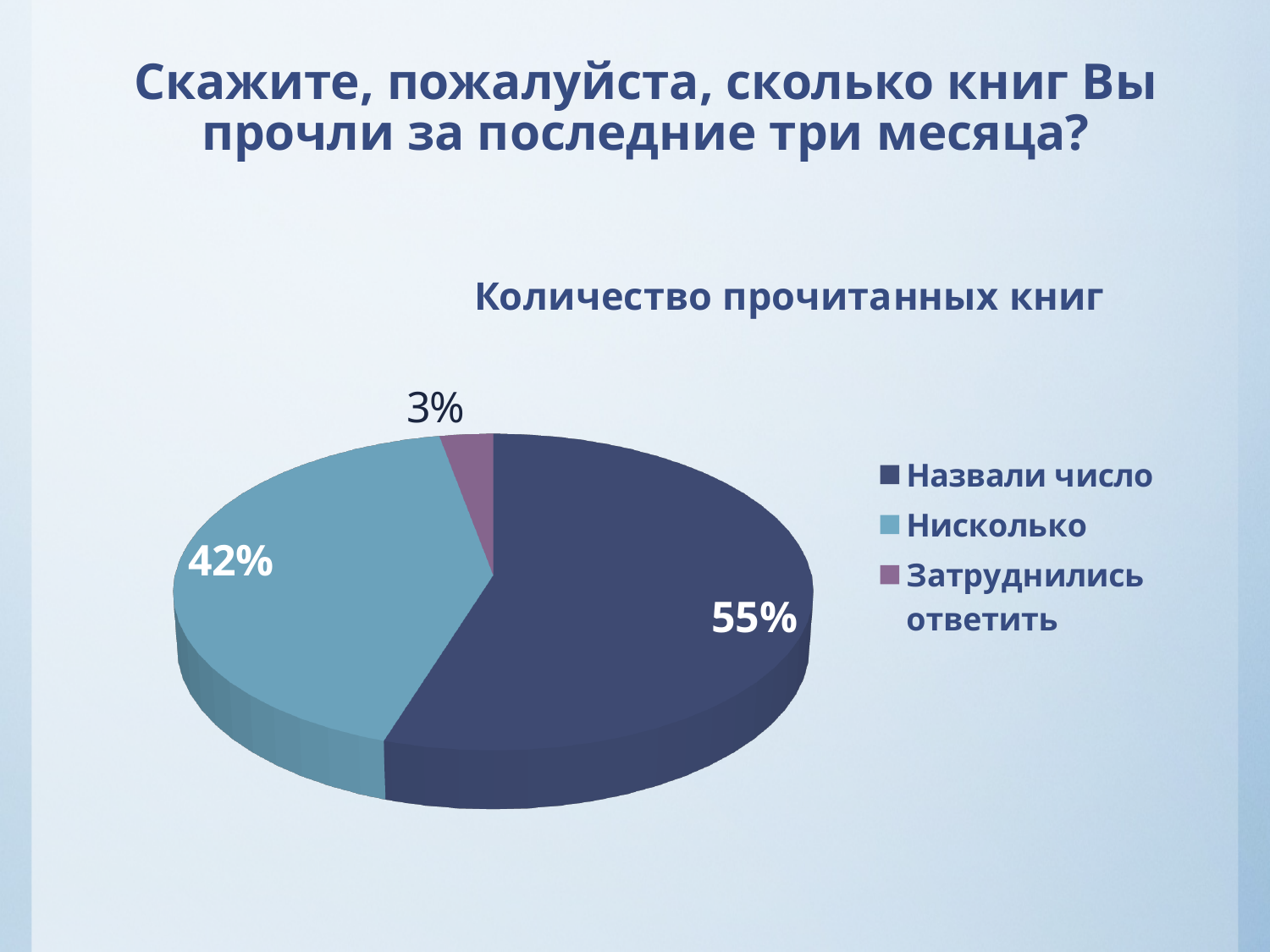
Which category has the largest slice of the pie? Назвали число How many categories does the pie chart show? 3 Which is larger, the share for "Назвали число" or the share for "Нисколько"? Назвали число What share of the pie does "Назвали число" take? 55% Which legend entry is shown in the purple colour? Затруднились ответить What share of the pie does "Нисколько" take? 42% Which category has the smallest slice of the pie? Затруднились ответить What is the difference in percentage points between "Нисколько" and "Затруднились ответить"? 39 What kind of chart is shown on the slide? Pie chart What is the difference in percentage points between "Назвали число" and "Нисколько"? 13 What share of the pie does "Затруднились ответить" take? 3% What is the title of the chart? Количество прочитанных книг